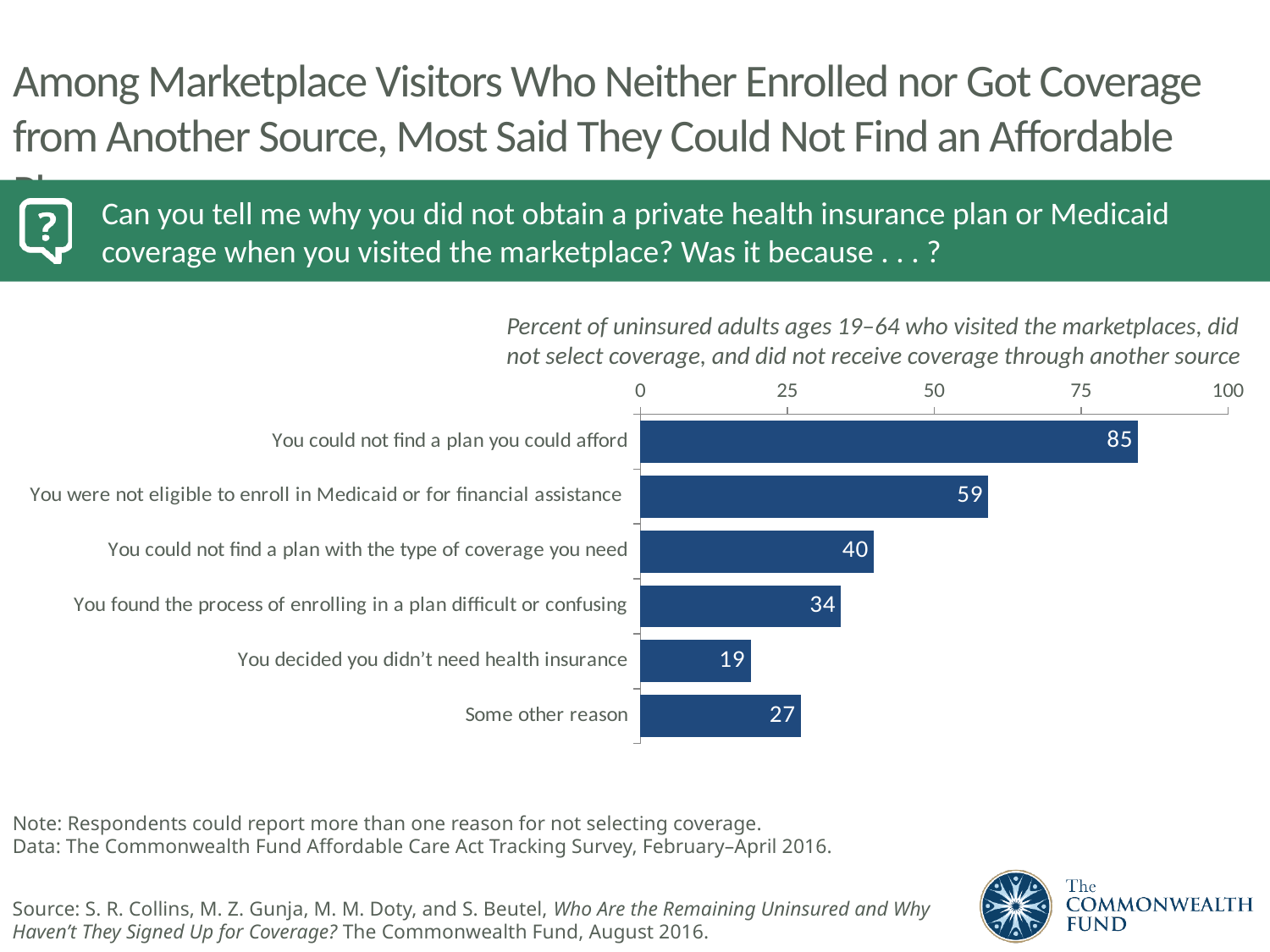
Which is larger: the value for 'Some other reason' or the value for 'You decided you didn't need health insurance'? Some other reason What kind of chart is shown on the slide? bar chart What value is shown for 'Some other reason'? 27 What value is shown for 'You were not eligible to enroll in Medicaid or for financial assistance'? 59 What value is shown for 'You found the process of enrolling in a plan difficult or confusing'? 34 How many reasons (bars) are shown in the chart? 6 Which reason has the highest value in the chart? You could not find a plan you could afford What is the maximum value shown on the chart's horizontal axis? 100 What percentage of respondents said they could not find a plan they could afford? 85 Is the value for 'You could not find a plan with the type of coverage you need' greater or less than 50? less What is the difference between the value for 'You could not find a plan you could afford' and 'You were not eligible to enroll in Medicaid or for financial assistance'? 26 Which reason has the lowest value in the chart? You decided you didn't need health insurance